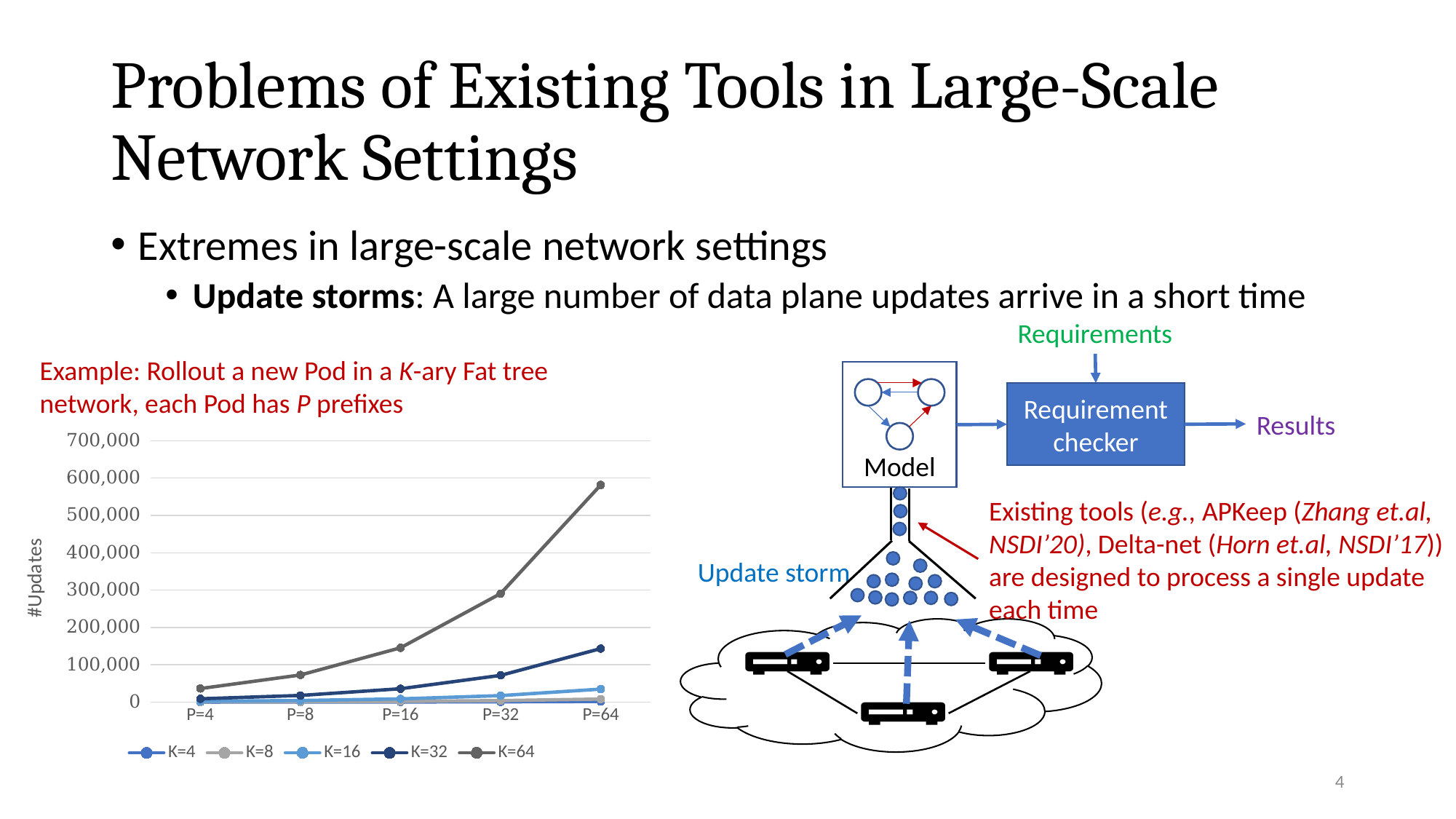
Is the value for K=64 at P=16 greater or less than 200,000? less At P=32, which series has the larger value, K=64 or K=32? K=64 Does the K=64 series rise or fall as P increases from P=4 to P=64? rise Is the value for K=64 at P=64 greater or less than 600,000? less What kind of chart is shown on the slide? line chart How many points are plotted along the x axis for each series? 5 What is the label on the chart's y axis? #Updates Is the value for K=64 at P=64 greater or less than 500,000? greater Which series has the highest value at P=64? K=64 How many series does the chart's legend list? 5